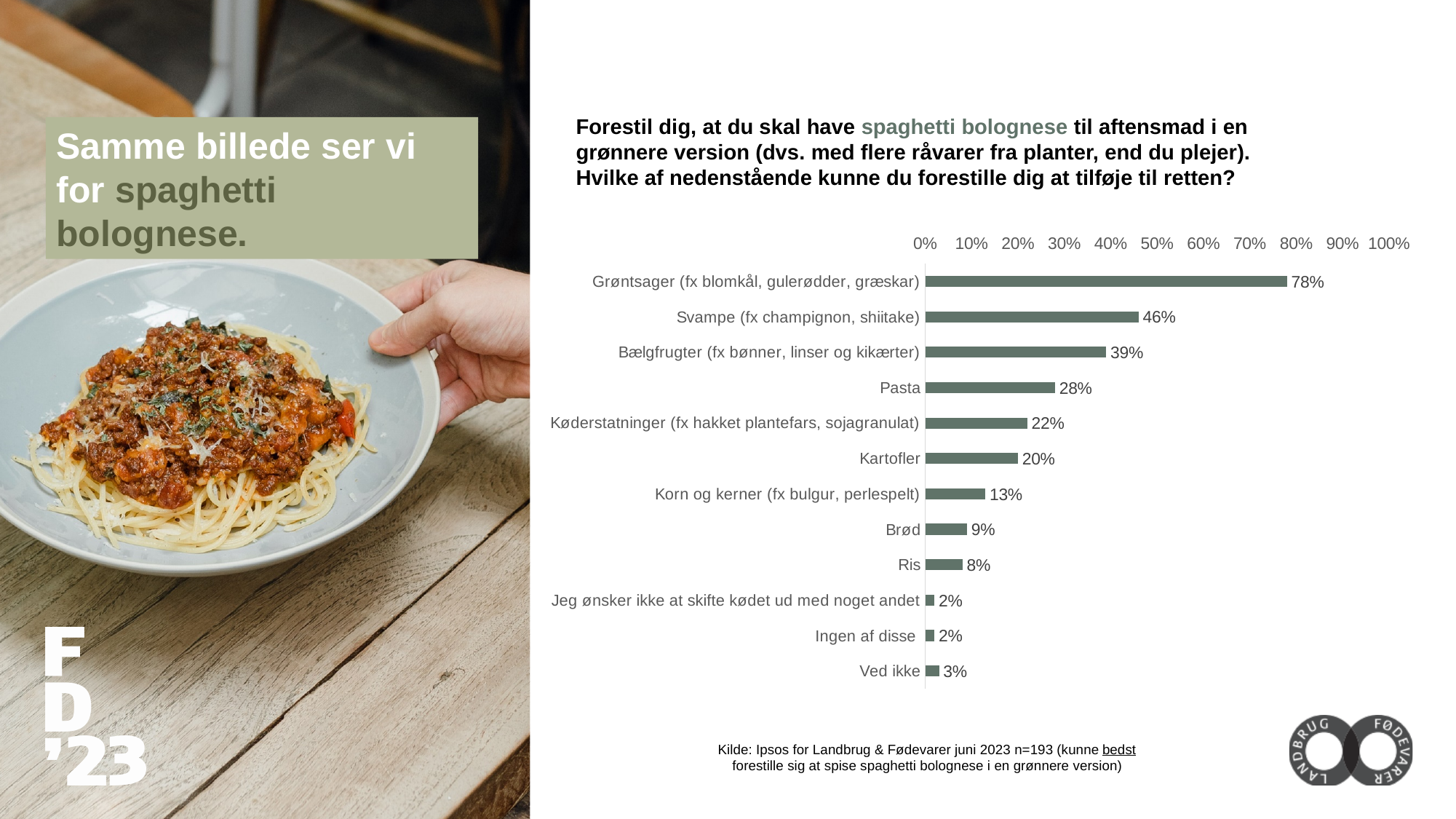
Is the value for Køderstatninger (fx hakket plantefars, sojagranulat) greater or less than 30%? less What is the difference between the values for Svampe (fx champignon, shiitake) and Bælgfrugter (fx bønner, linser og kikærter)? 7% What is the value for Grøntsager (fx blomkål, gulerødder, græskar)? 78% What is the value for Kartofler? 20% What kind of chart is shown on the slide? bar chart What is the highest value shown on the percentage axis of the chart? 100% What is the value for Pasta? 28% What is the difference between the values for Grøntsager (fx blomkål, gulerødder, græskar) and Pasta? 50% How many categories are shown in the chart? 12 Which category has the highest value? Grøntsager (fx blomkål, gulerødder, græskar) What is the value for Ved ikke? 3% Which is larger, the value for Brød or the value for Ris? Brød